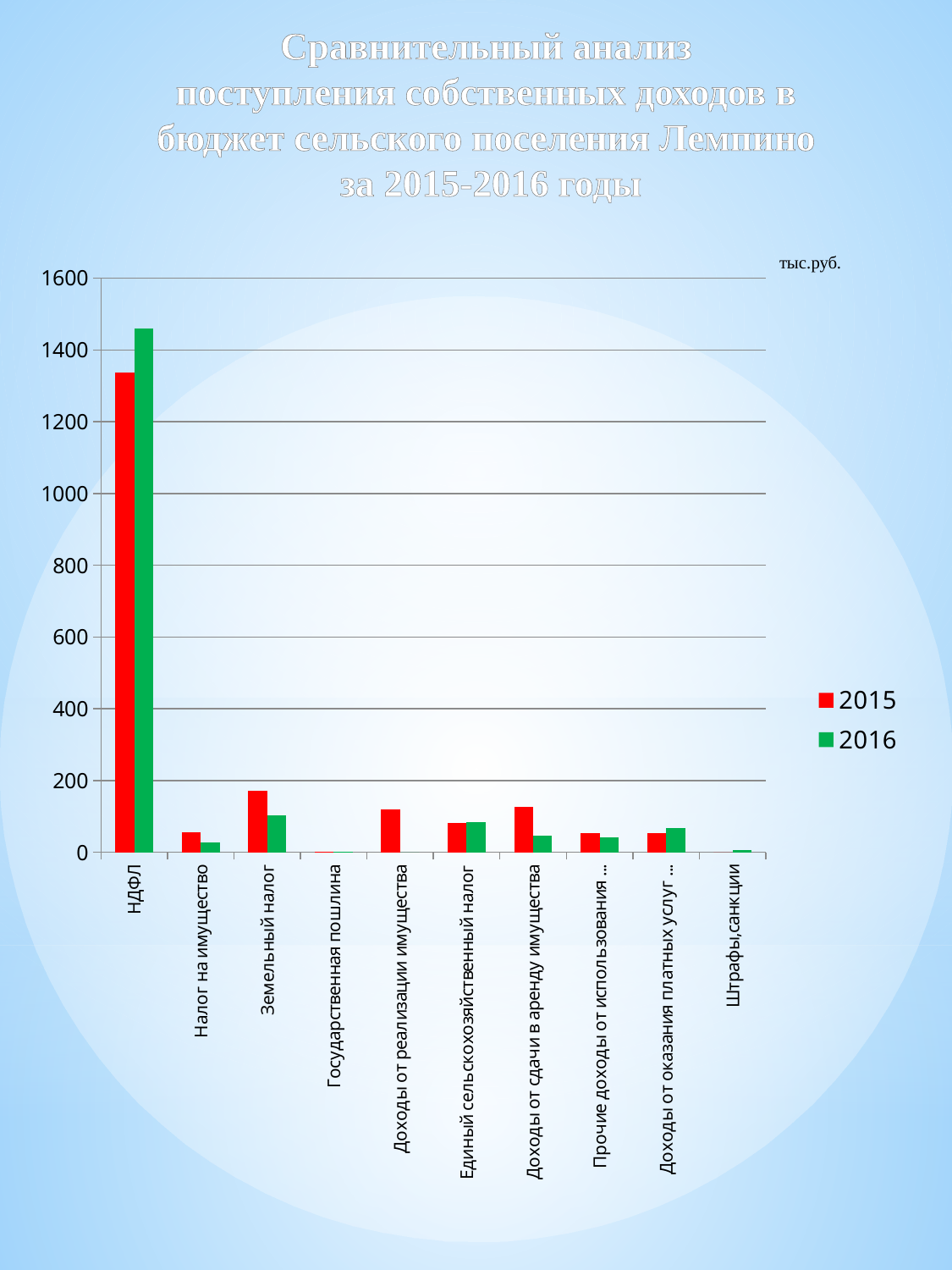
Is the 2016 value for НДФЛ greater or less than 1400? greater How many categories are shown on the x axis? 10 How many series does the legend list? 2 Which category has the highest value for 2015? НДФЛ What kind of chart is shown on the slide? bar chart For НДФЛ, which year has the larger value, 2015 or 2016? 2016 What colour represents the 2016 series in the legend? green For Доходы от сдачи в аренду имущества, which year has the larger value, 2015 or 2016? 2015 Is the 2015 value for Земельный налог greater or less than 200? less For Земельный налог, which year has the larger value, 2015 or 2016? 2015 Which category has the highest value for 2016? НДФЛ Is the 2015 value for НДФЛ greater or less than 1400? less